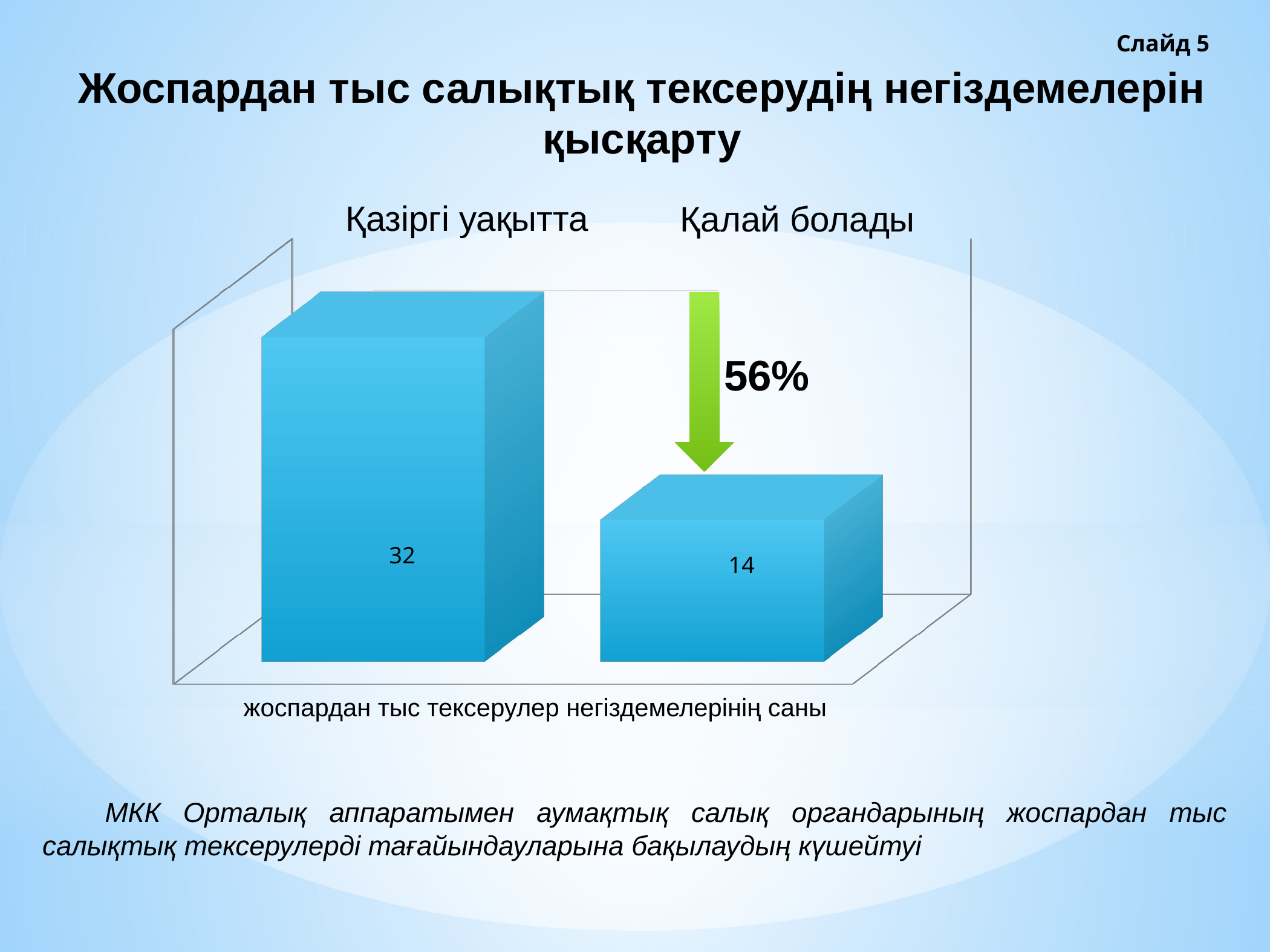
What is the value for "Қазіргі уақытта"? 32 What is the value for "Қалай болады"? 14 Which is larger, the value for "Қазіргі уақытта" or for "Қалай болады"? Қазіргі уақытта Which category has the highest value? Қазіргі уақытта What is the label printed below the chart's bars? жоспардан тыс тексерулер негіздемелерінің саны Do the values rise or fall from left to right across the chart? fall Which category has the lowest value? Қалай болады What kind of chart is shown on the slide? bar chart How many bars are shown in the chart? 2 What is the difference between the values for "Қазіргі уақытта" and "Қалай болады"? 18 What percentage reduction is shown next to the green arrow on the chart? 56%